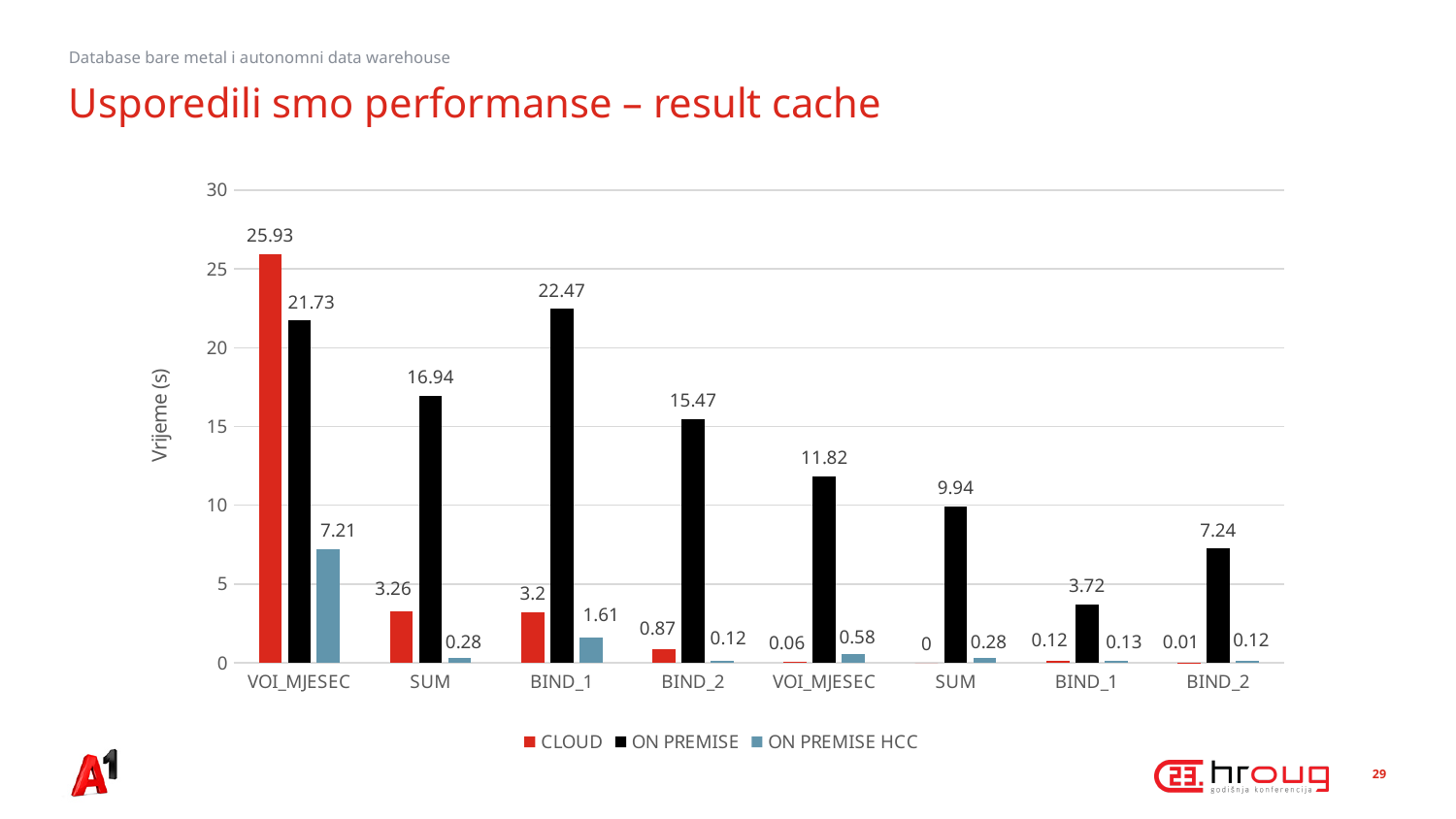
What is the label of the y axis? Vrijeme (s) In the first SUM group (second from the left), which is larger: the CLOUD value or the ON PREMISE value? ON PREMISE What is the ON PREMISE value for the second BIND_2 group (rightmost)? 7.24 What is the ON PREMISE HCC value for the first VOI_MJESEC group (leftmost)? 7.21 Which category group has the highest CLOUD value? VOI_MJESEC (first, leftmost group) What is the CLOUD value for the first VOI_MJESEC group (leftmost)? 25.93 What is the difference between the CLOUD and ON PREMISE values in the first VOI_MJESEC group (leftmost)? 4.2 How many series does the legend list? 3 Which category group has the lowest ON PREMISE value? BIND_1 (second occurrence, seventh group) What is the ON PREMISE value for the first BIND_1 group (third from the left)? 22.47 What type of chart is shown on the slide? bar chart How many category groups are shown along the x axis? 8